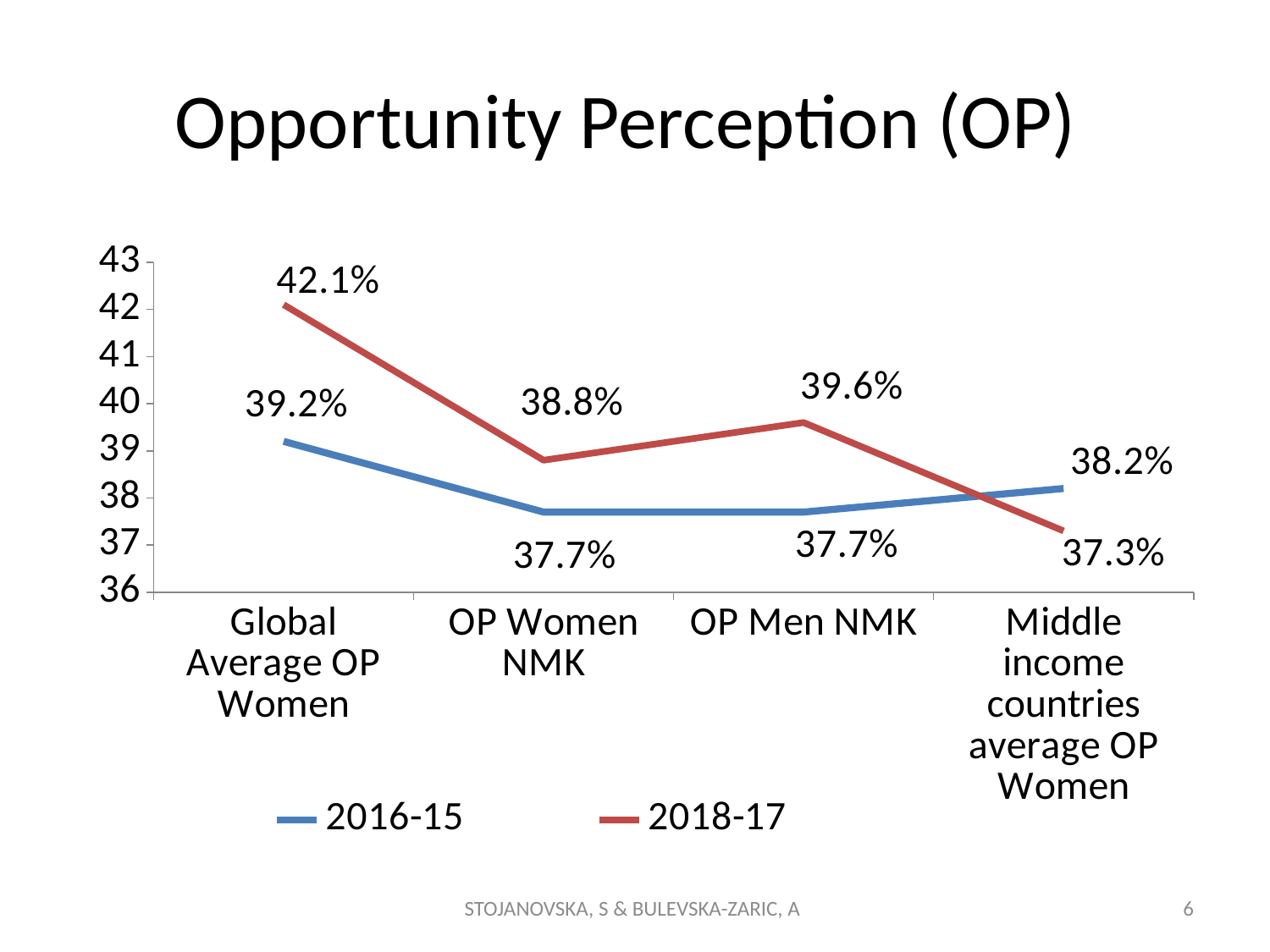
Which category has the highest 2018-17 value? Global Average OP Women What kind of chart is shown on the slide? line chart Which category has the lowest 2018-17 value? Middle income countries average OP Women What is the 2016-15 value for OP Women NMK? 37.7% What is the 2018-17 value for Global Average OP Women? 42.1% For Middle income countries average OP Women, which series has the larger value, 2016-15 or 2018-17? 2016-15 What is the 2016-15 value for Middle income countries average OP Women? 38.2% What is the title of the chart? Opportunity Perception (OP) How many series does the legend list? 2 How many categories are shown on the x axis? 4 What is the 2018-17 value for OP Men NMK? 39.6% What is the difference between the 2018-17 and 2016-15 values for Global Average OP Women? 2.9%